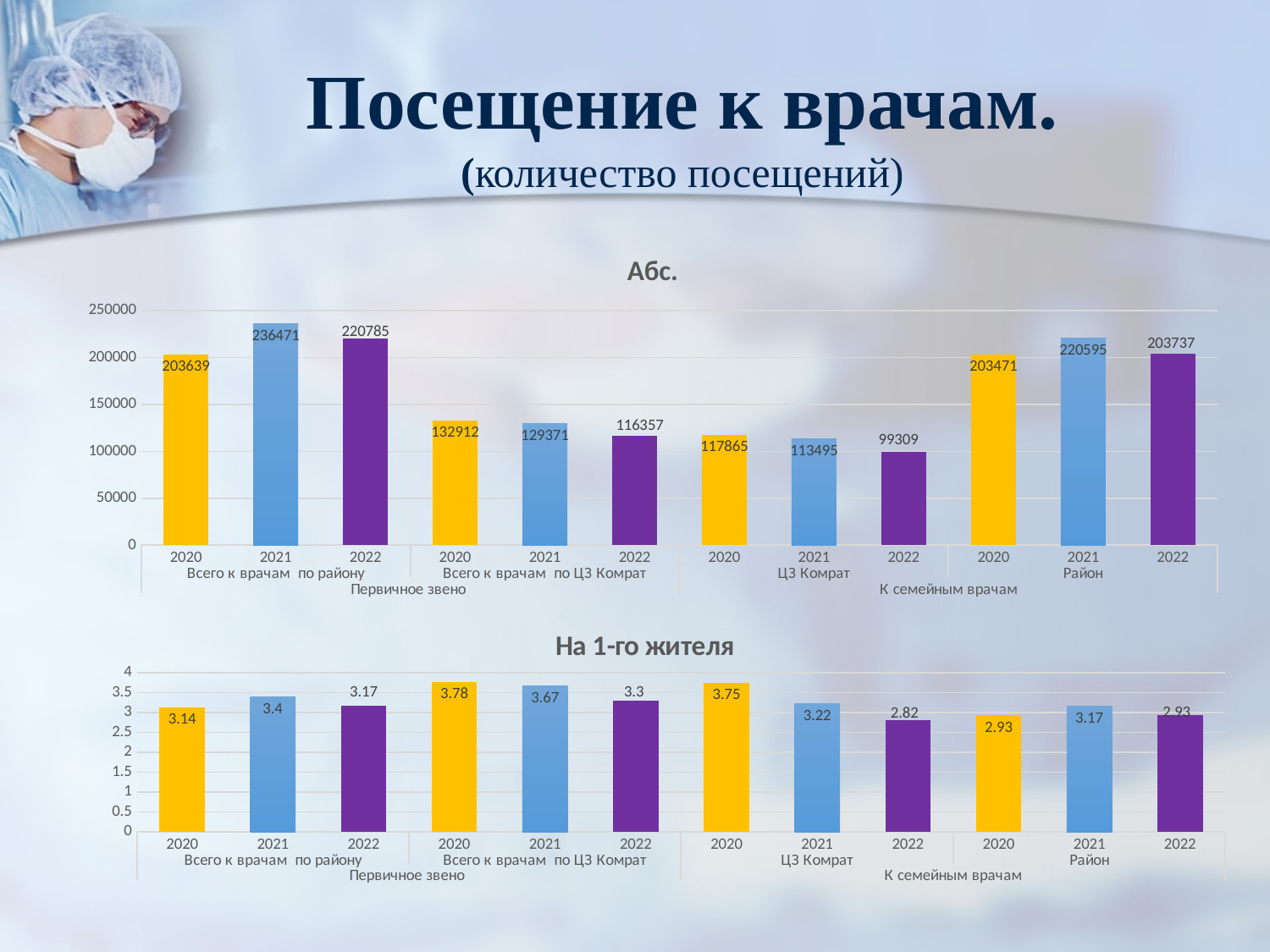
In the chart titled "Абс.", how do the values change from 2020 to 2022 under "Всего к врачам по ЦЗ Комрат"? They fall In the chart titled "На 1-го жителя", what is the value for 2020 under "Всего к врачам по ЦЗ Комрат"? 3.78 In the chart titled "На 1-го жителя", what is the difference between the 2020 and 2022 values under "ЦЗ Комрат" (К семейным врачам)? 0.93 What type of chart is the chart titled "На 1-го жителя"? Bar chart In the chart titled "Абс.", what is the value for 2021 under "Всего к врачам по району"? 236471 How many bars are plotted in the chart titled "Абс."? 12 In the chart titled "Абс.", what is the value for 2022 under "ЦЗ Комрат" (К семейным врачам)? 99309 In the chart titled "Абс.", which bar has the highest value? 2021, Всего к врачам по району In the chart titled "Абс.", which bar has the lowest value? 2022, ЦЗ Комрат (К семейным врачам) In the chart titled "На 1-го жителя", which is larger: the 2021 value under "Всего к врачам по району" or the 2021 value under "Всего к врачам по ЦЗ Комрат"? Всего к врачам по ЦЗ Комрат (3.67) In the chart titled "Абс.", what is the difference between the 2021 and 2020 values under "Всего к врачам по району"? 32832 In the chart titled "На 1-го жителя", which bar has the lowest value? 2022, ЦЗ Комрат (К семейным врачам)